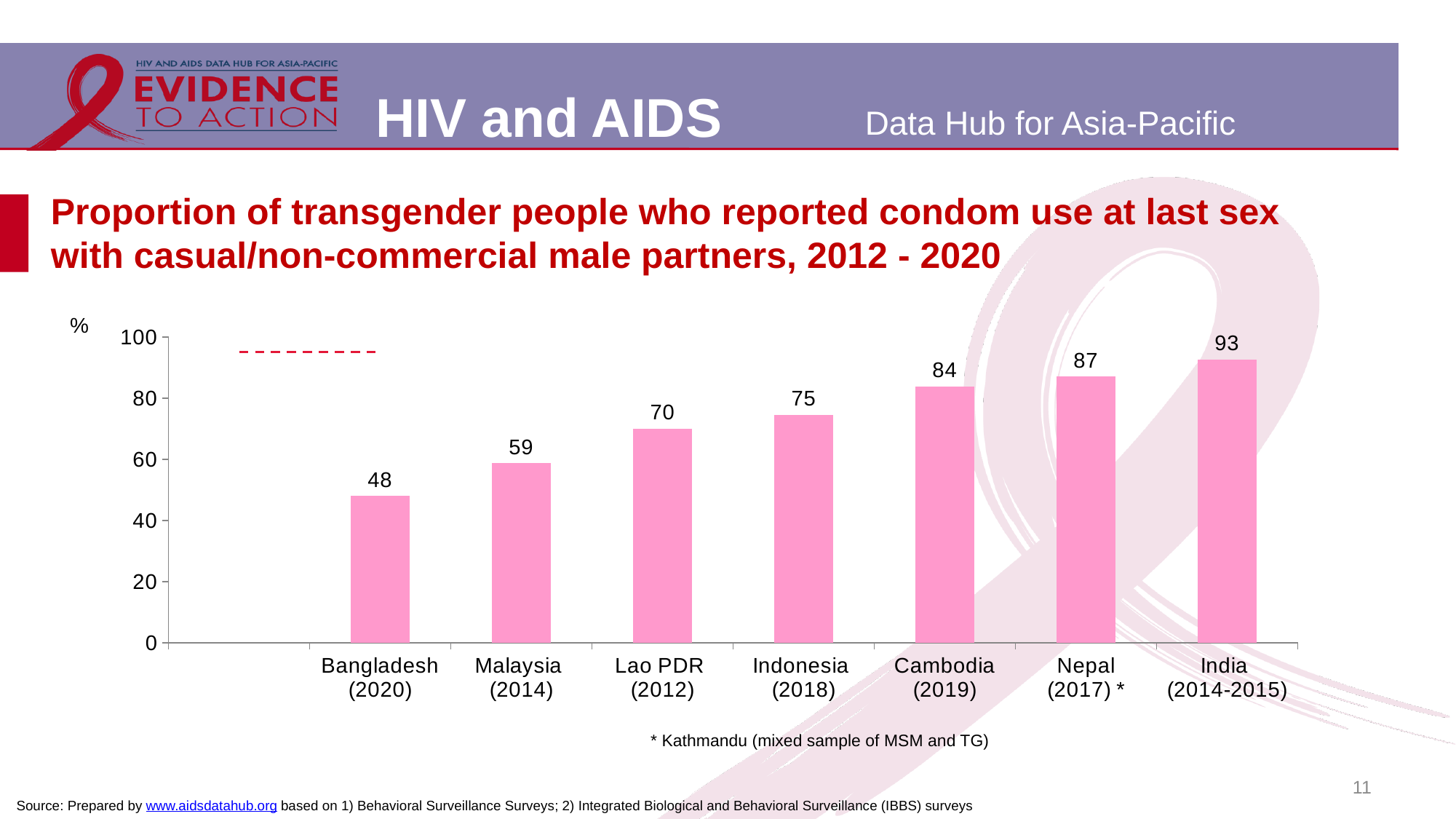
Is the value for Cambodia (2019) greater or less than 80? greater What is the value for Indonesia (2018)? 75 What is the difference between the values for India (2014-2015) and Bangladesh (2020)? 45 Do the values rise or fall from left to right across the countries? Rise Which is larger, the value for Lao PDR (2012) or the value for Malaysia (2014)? Lao PDR (2012) How many countries are shown on the chart? 7 What is the difference between the values for Cambodia (2019) and Malaysia (2014)? 25 Which country has the highest proportion of transgender people reporting condom use at last sex with casual/non-commercial male partners? India (2014-2015) Which country has the lowest value on the chart? Bangladesh (2020) What is the value for Nepal (2017)? 87 What is the value for Bangladesh (2020)? 48 What kind of chart is shown on the slide? Bar chart